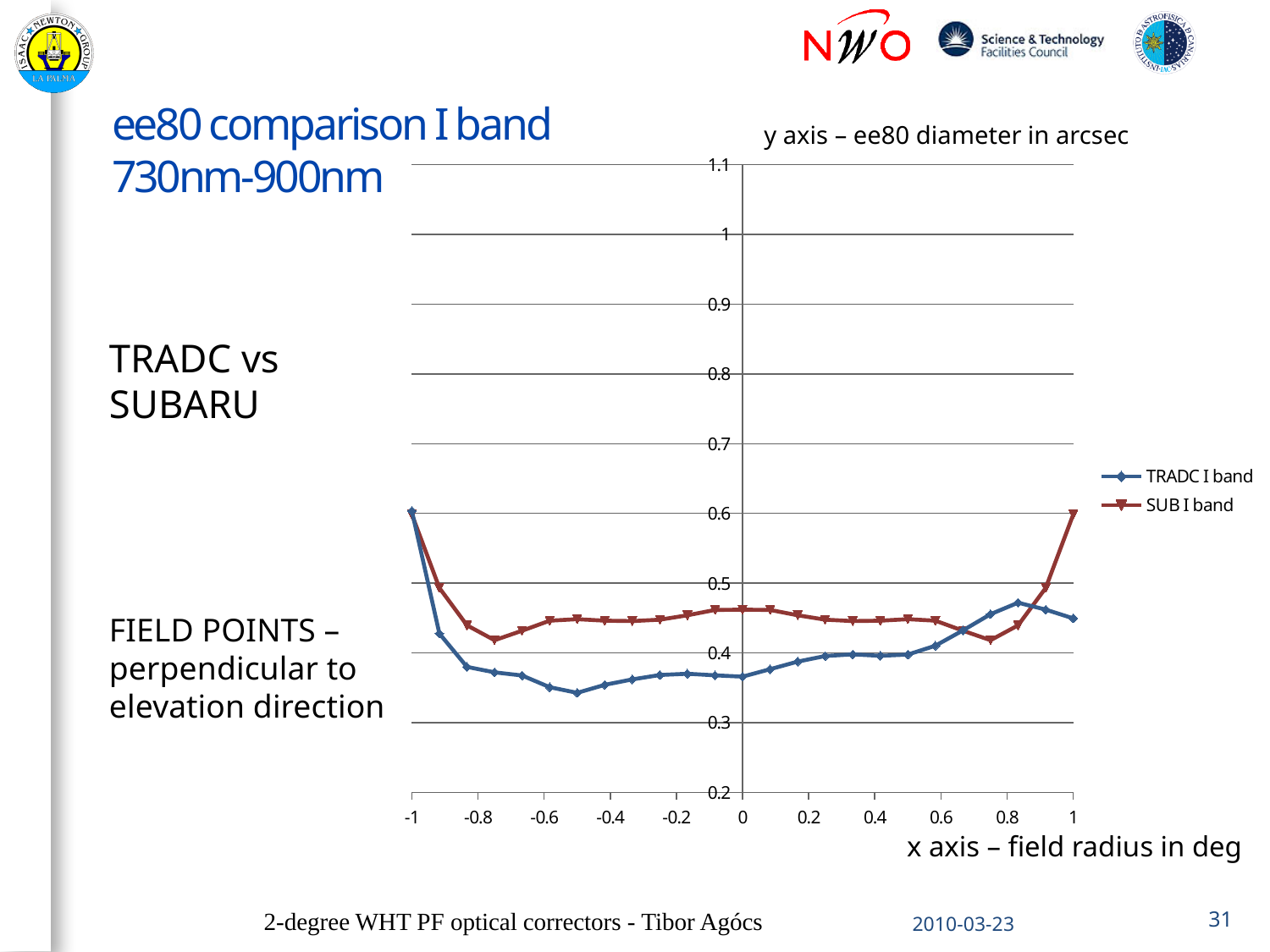
Is the TRADC I band value at x = 0 greater or less than 0.4? less Is the SUB I band value at x = 0 greater or less than 0.5? less What quantity does the y axis represent according to the slide? ee80 diameter in arcsec What kind of chart is shown on the slide? line chart At x = 0, which series has the larger value, TRADC I band or SUB I band? SUB I band What are the two series named in the legend? TRADC I band and SUB I band Does the SUB I band series rise or fall between x = 0.6 and x = 1? rise How many series does the legend list? 2 Is the SUB I band value at x = 0 greater or less than 0.4? greater Does the TRADC I band series rise or fall between x = -1 and x = -0.8? fall At x = 1, which series has the larger value, TRADC I band or SUB I band? SUB I band